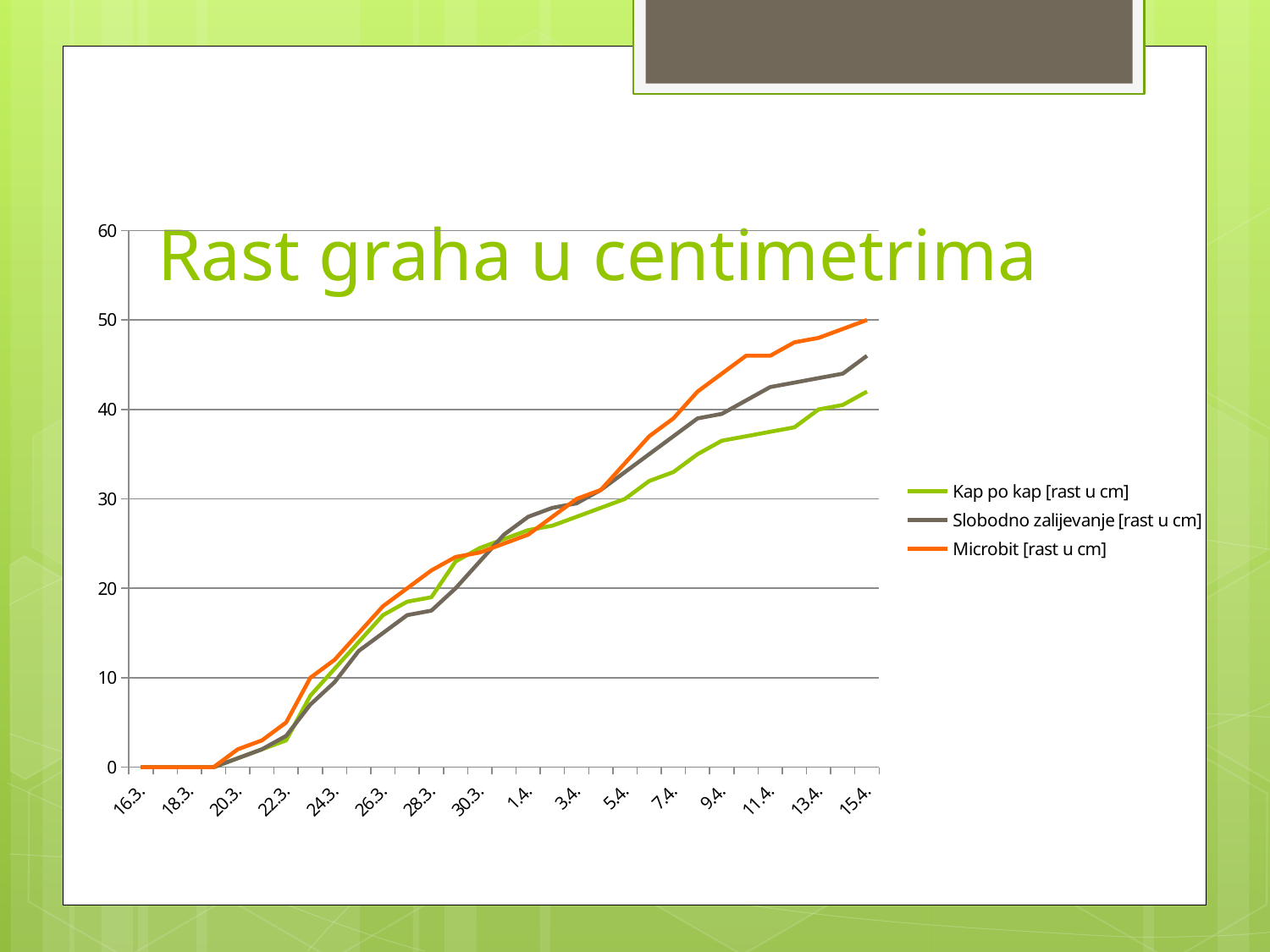
What kind of chart is shown on the slide? line chart Which colour is used for the Microbit [rast u cm] series? orange Which series has the lowest value at 15.4.? Kap po kap [rast u cm] Do the values of the series rise or fall along the x axis from 16.3. to 15.4.? rise What is the title of the chart? Rast graha u centimetrima Is the value for Slobodno zalijevanje [rast u cm] at 15.4. greater or less than 50? less At 15.4., which is larger: Microbit [rast u cm] or Kap po kap [rast u cm]? Microbit [rast u cm] How many series does the legend list? 3 What is the value of Kap po kap [rast u cm] at 16.3.? 0 Is the value for Slobodno zalijevanje [rast u cm] at 28.3. greater or less than 20? less Is the value for Kap po kap [rast u cm] at 15.4. greater or less than 40? greater Which series has the highest value at 15.4.? Microbit [rast u cm]